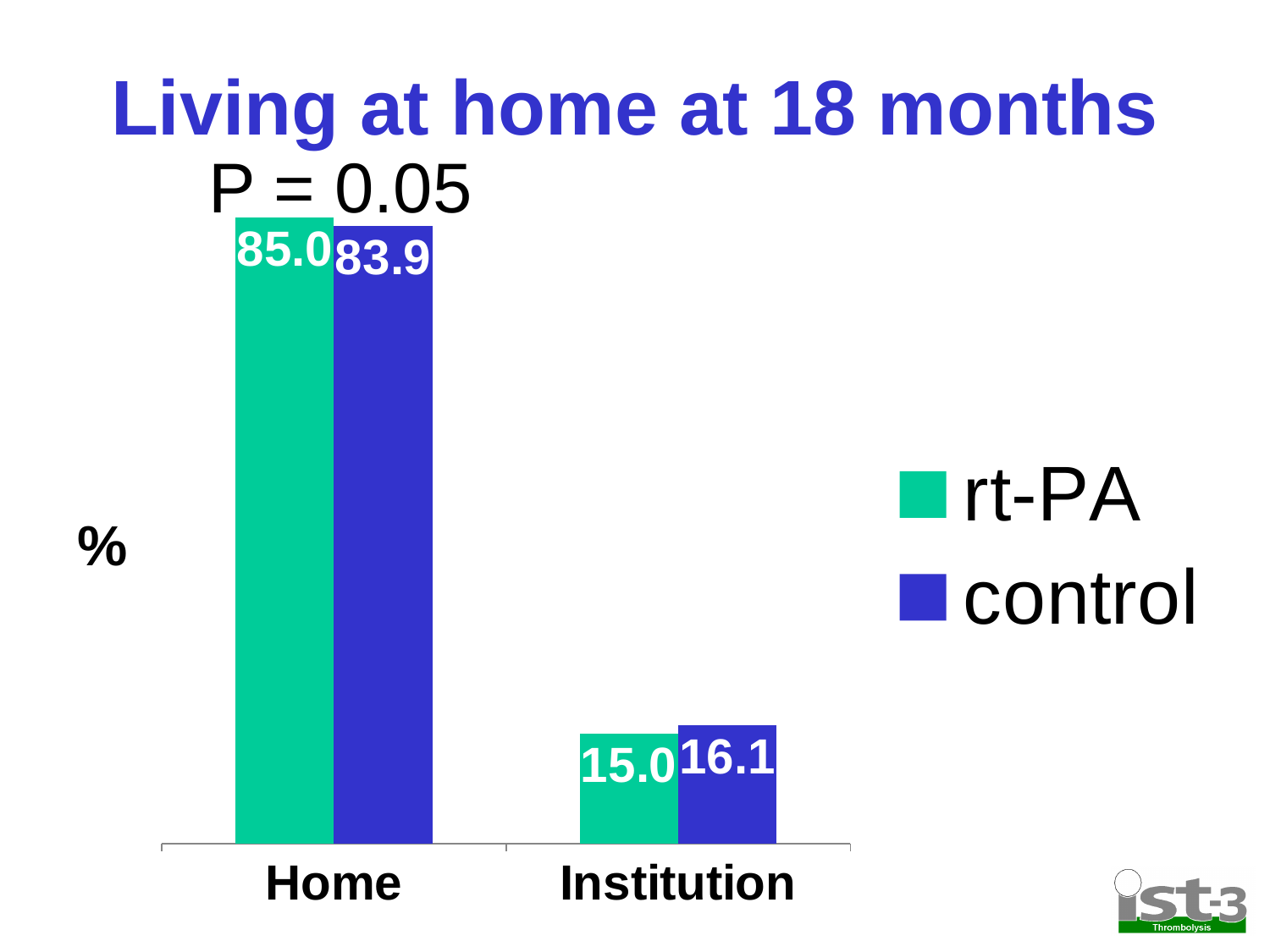
What is the difference between the rt-PA and control values for Home? 1.1 What is the control value for Institution? 16.1 What is the control value for Home? 83.9 What is the rt-PA value for Institution? 15.0 What is the title of the chart? Living at home at 18 months What is the rt-PA value for Home? 85.0 How many categories are shown on the x axis? 2 What is the difference between the control and rt-PA values for Institution? 1.1 What kind of chart is shown on the slide? bar chart Which category has the highest rt-PA value? Home How many series does the legend list? 2 Which category has the lowest control value? Institution